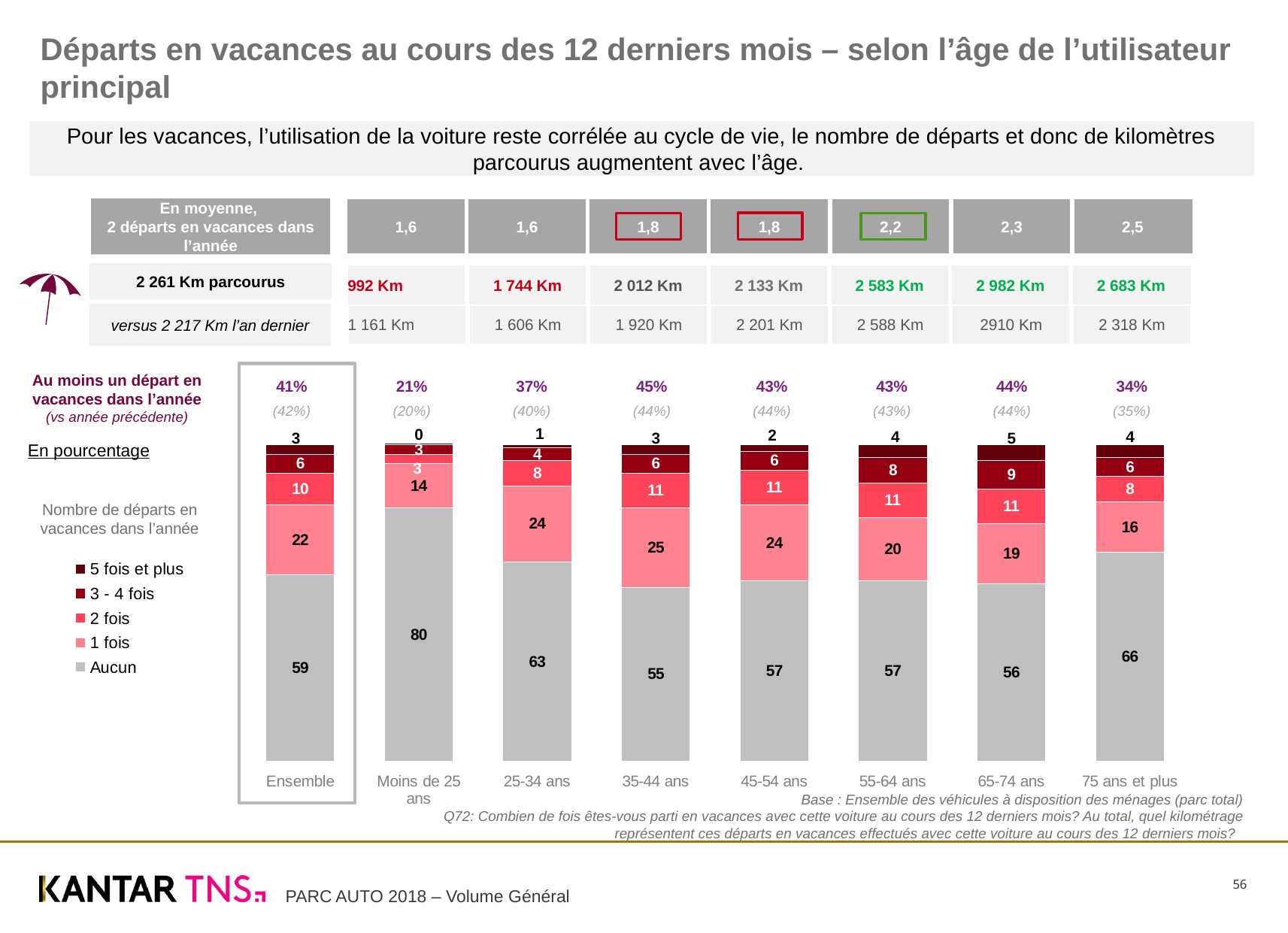
What is the value of '5 fois et plus' for the '65-74 ans' category? 5 How many series does the chart legend list? 5 What is the value of '1 fois' for the '35-44 ans' category? 25 Which category has the highest 'Aucun' value? Moins de 25 ans What is the difference between the 'Aucun' values for '75 ans et plus' and '35-44 ans'? 11 Which legend entry is shown in grey? Aucun How many categories (bars) are plotted in the chart? 8 What is the value of 'Aucun' for the 'Moins de 25 ans' category? 80 Which is larger: the '2 fois' value for 'Ensemble' or for '55-64 ans'? 55-64 ans What is the total of the stacked bar for the '25-34 ans' category? 100 What kind of chart is shown on the slide? Stacked bar chart Which category has the lowest '1 fois' value? Moins de 25 ans